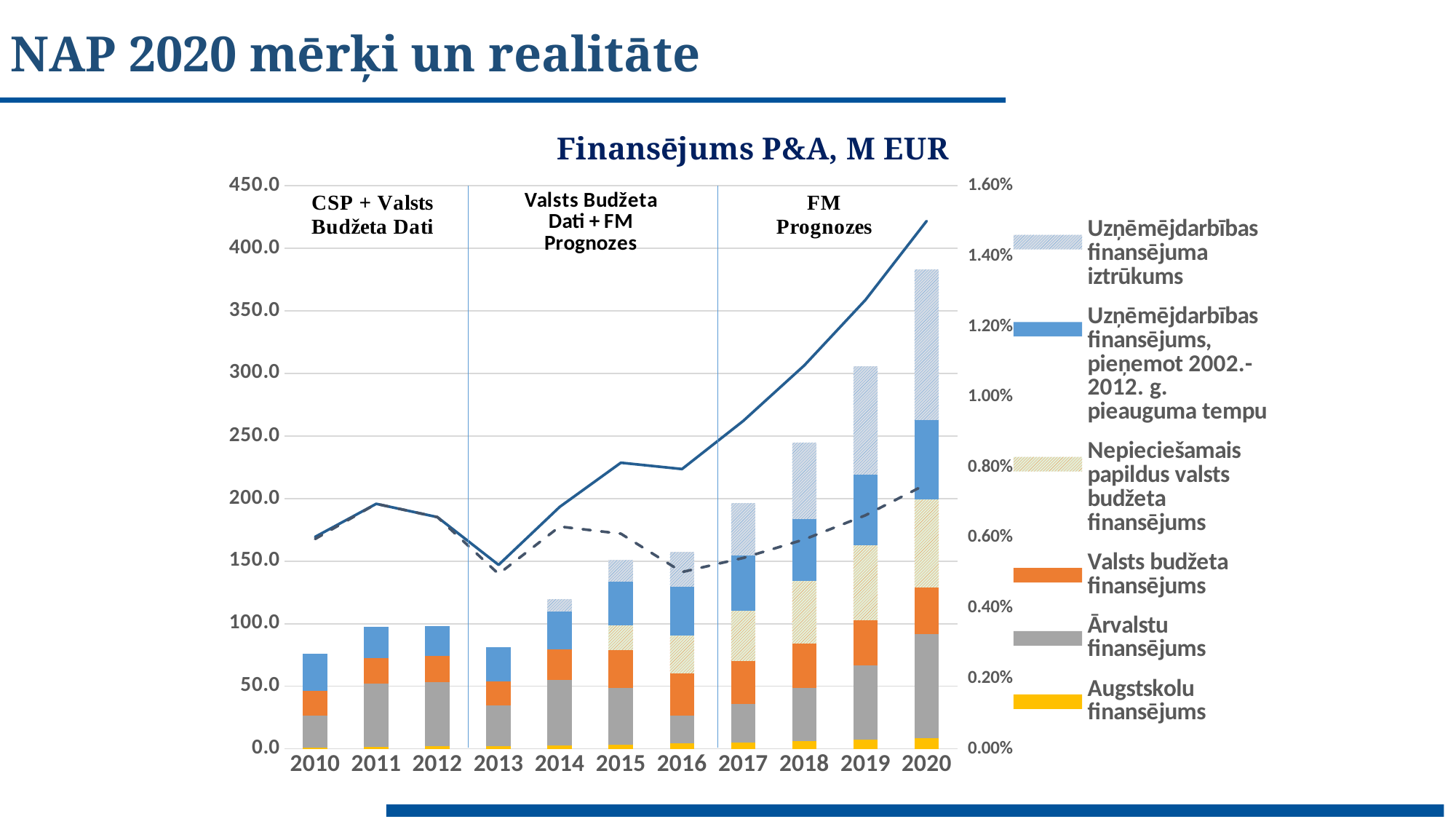
How many years are shown on the x axis of the chart? 11 How many series does the chart legend list? 6 Is the total stacked bar for 2020 greater or less than 350.0? greater Which colour represents 'Valsts budžeta finansējums' in the legend? Orange Is the total stacked bar for 2014 greater or less than 150.0? less Is the total stacked bar for 2010 greater or less than 100.0? less What is the title of the chart? Finansējums P&A, M EUR Which year has the larger total stacked bar, 2011 or 2013? 2011 Which year has the tallest stacked bar? 2020 Do the stacked bar totals generally rise or fall from 2013 to 2020? rise What type of chart is shown on the slide? Stacked bar chart with lines